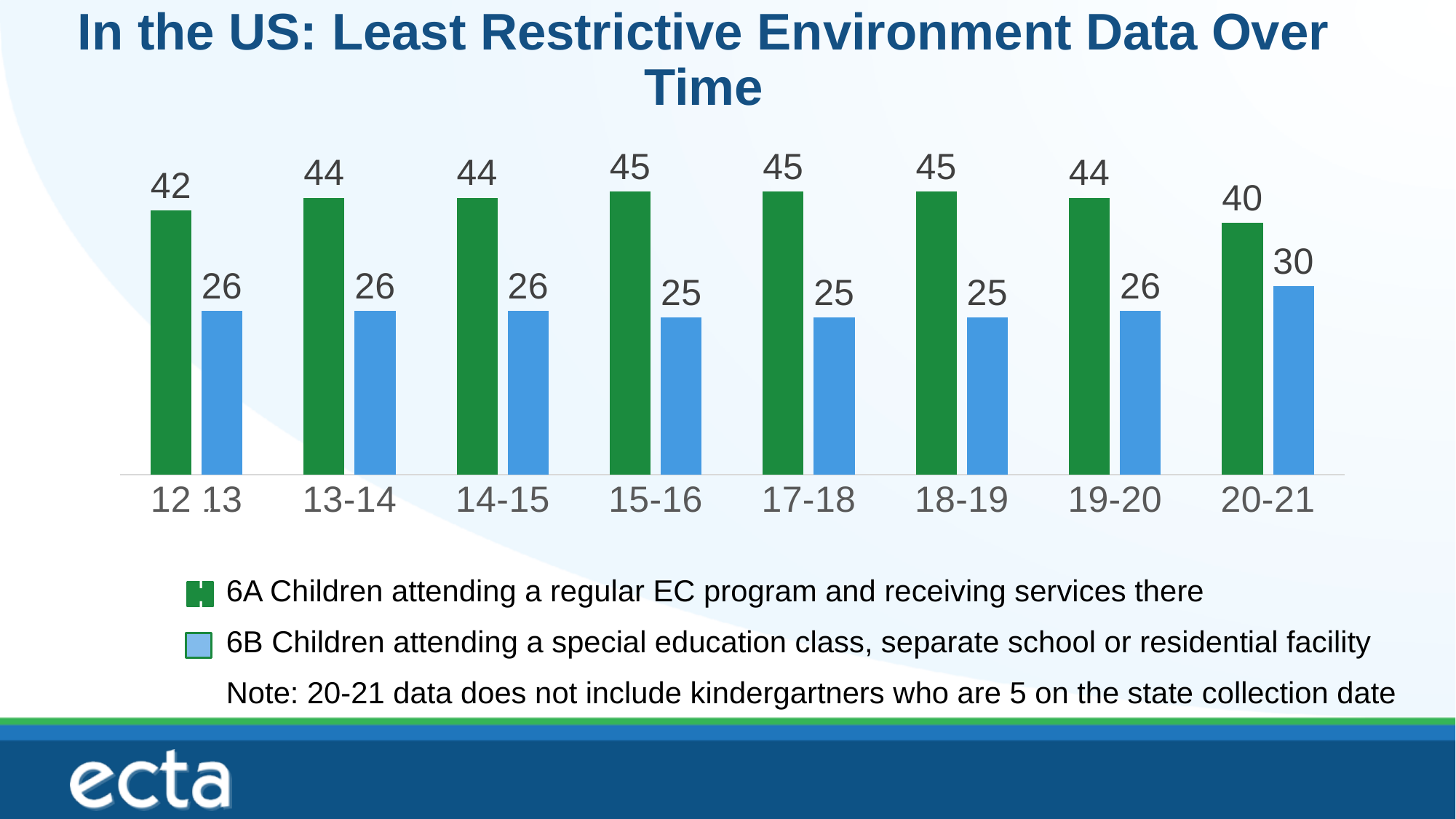
In 14-15, which series has the larger value, 6A or 6B? 6A By how much did the 6A value fall from 17-18 to 20-21? 5 What is the value of the 6A series (children attending a regular EC program) for 20-21? 40 What is the 6A value for 13-14? 44 What is the value of the 6B series (special education class, separate school or residential facility) for 15-16? 25 What is the 6B value for 19-20? 26 How many series does the legend list? 2 What kind of chart is shown on the slide? Bar chart How many year categories are shown on the x axis? 8 What is the difference between the 6A and 6B values in 18-19? 20 In which year is the 6A value the lowest? 20-21 In which year is the 6B value the highest? 20-21